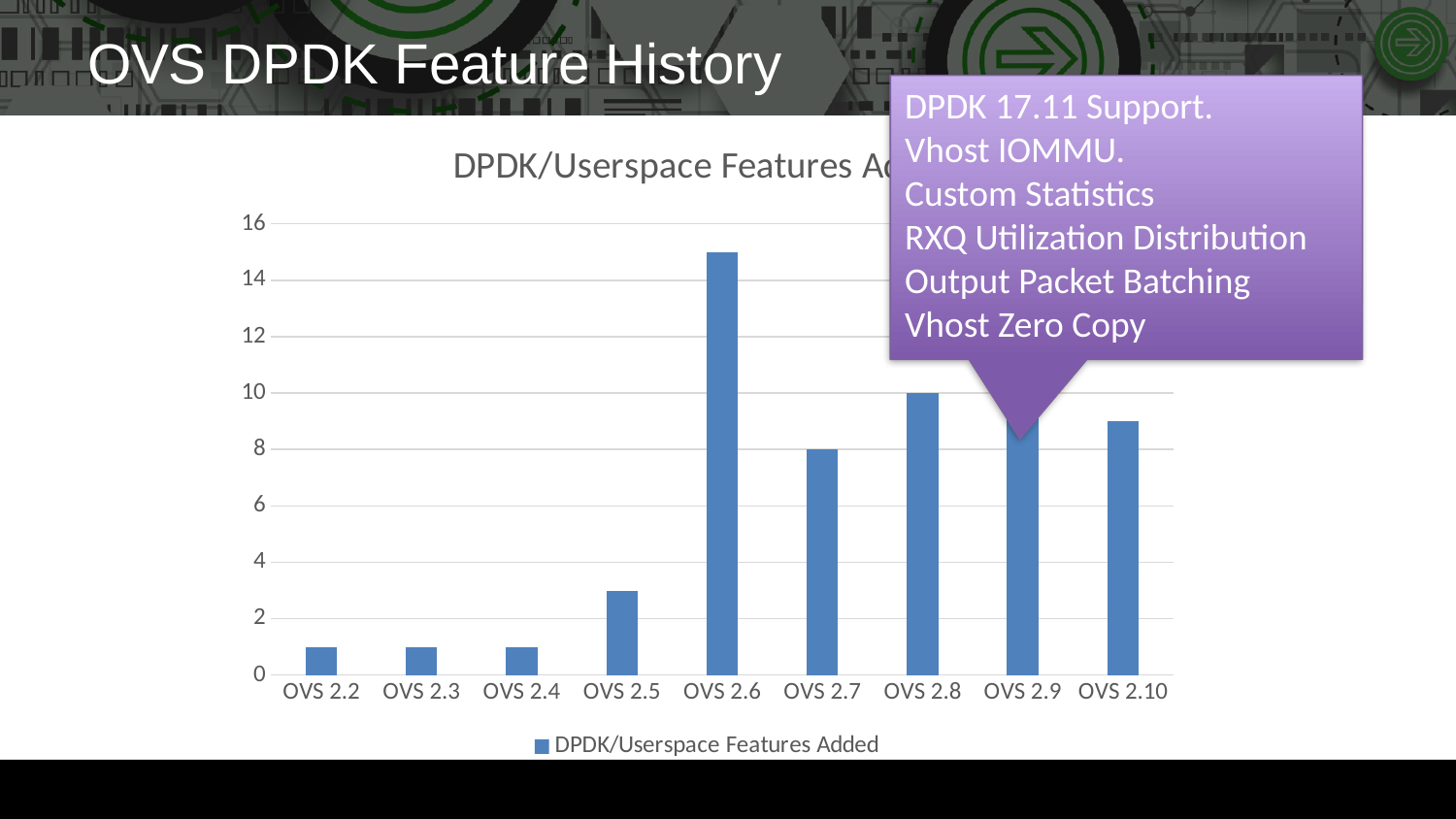
Is the value for OVS 2.2 greater or less than 2? less Is the value for OVS 2.6 greater or less than 14? greater How many DPDK/Userspace features were added in OVS 2.7? 8 What is the legend entry for the series? DPDK/Userspace Features Added What kind of chart is shown on the slide? bar chart Which OVS version has the highest number of DPDK/Userspace features added? OVS 2.6 Which is larger, the value for OVS 2.6 or the value for OVS 2.8? OVS 2.6 How many DPDK/Userspace features were added in OVS 2.8? 10 How many series does the legend list? 1 How many OVS versions (categories) are shown on the x axis? 9 Do the values rise or fall from OVS 2.2 to OVS 2.6? rise What is the difference between the values for OVS 2.8 and OVS 2.7? 2